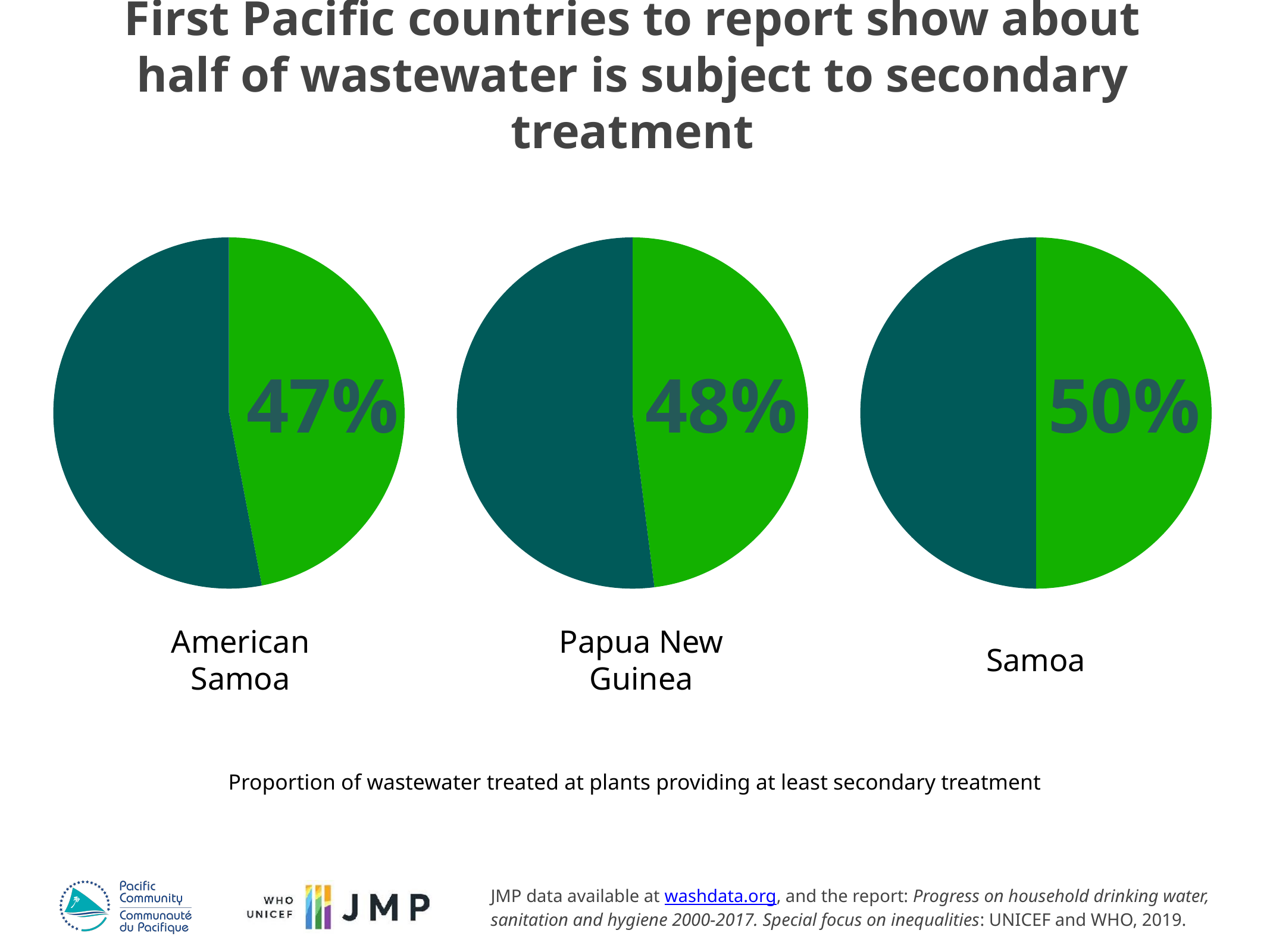
What percentage of wastewater is treated at plants providing at least secondary treatment in American Samoa? 47% Which country's pie chart is in the middle of the slide? Papua New Guinea What percentage of wastewater is treated at plants providing at least secondary treatment in Papua New Guinea? 48% How many countries are shown on the slide? 3 What kind of chart is used to show each country's value? Pie chart What share of the Samoa pie is taken by the bright green slice? 50% Which country shows the highest proportion of wastewater subject to at least secondary treatment? Samoa What percentage of wastewater is treated at plants providing at least secondary treatment in Samoa? 50% What is the difference in percentage points between Papua New Guinea and American Samoa? 1 What does the caption below the charts say the values represent? Proportion of wastewater treated at plants providing at least secondary treatment Which country shows the lowest proportion of wastewater subject to at least secondary treatment? American Samoa What is the difference in percentage points between Samoa and American Samoa? 3